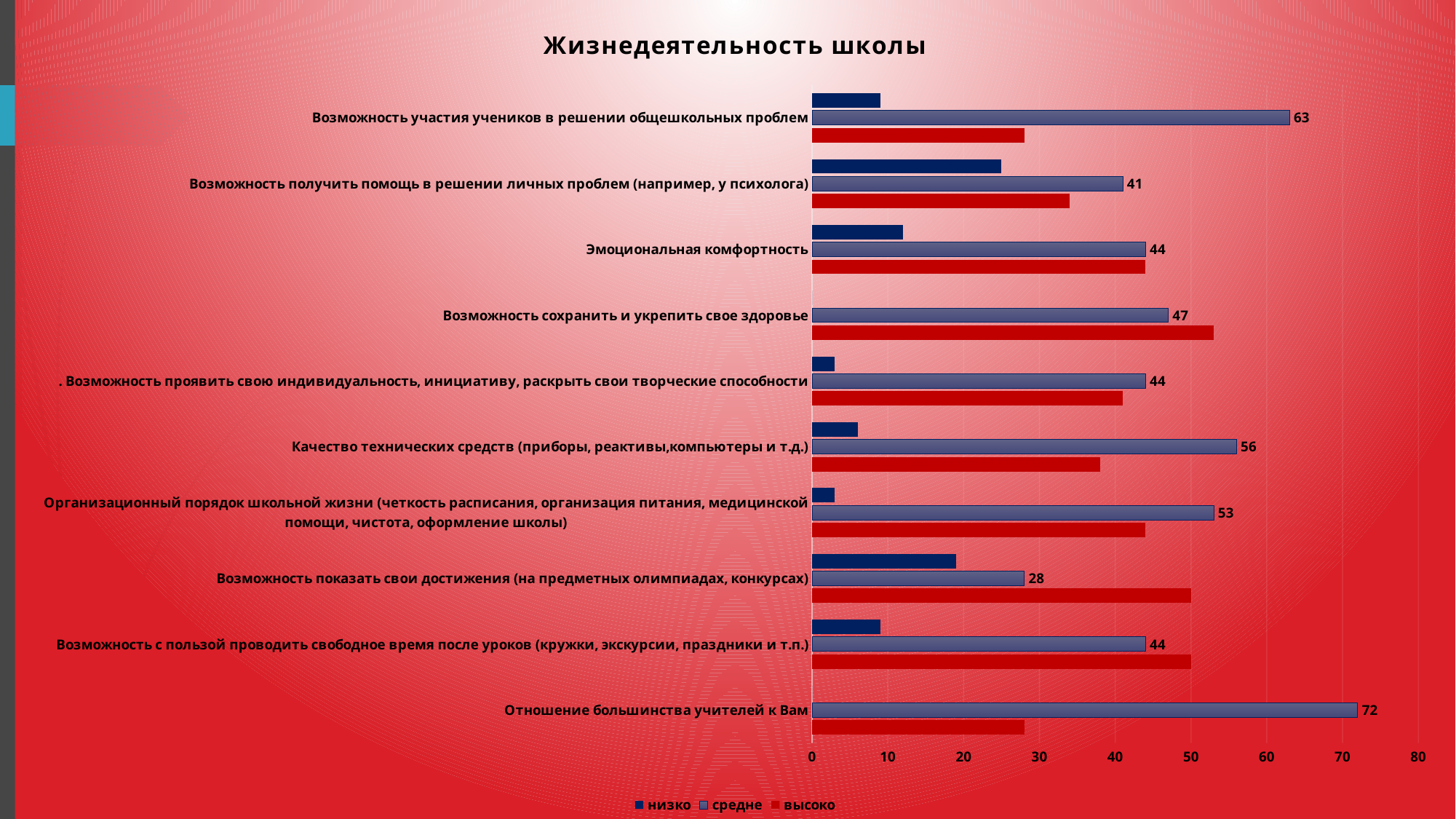
What is the value of the "средне" series for "Отношение большинства учителей к Вам"? 72 How many series does the legend list? 3 Which category has the highest value in the "средне" series? Отношение большинства учителей к Вам What is the value of the "средне" series for "Качество технических средств (приборы, реактивы,компьютеры и т.д.)"? 56 Is the "высоко" value for "Отношение большинства учителей к Вам" greater or less than 30? less What is the difference between the "средне" values for "Отношение большинства учителей к Вам" and "Возможность показать свои достижения (на предметных олимпиадах, конкурсах)"? 44 How many categories are shown on the chart? 10 What type of chart is shown on the slide? Bar chart Is the "высоко" value for "Возможность сохранить и укрепить свое здоровье" greater or less than 50? greater What is the value of the "средне" series for "Возможность участия учеников в решении общешкольных проблем"? 63 Which category has the lowest value in the "средне" series? Возможность показать свои достижения (на предметных олимпиадах, конкурсах) In the "средне" series, which is larger: "Возможность участия учеников в решении общешкольных проблем" or "Возможность получить помощь в решении личных проблем (например, у психолога)"? Возможность участия учеников в решении общешкольных проблем